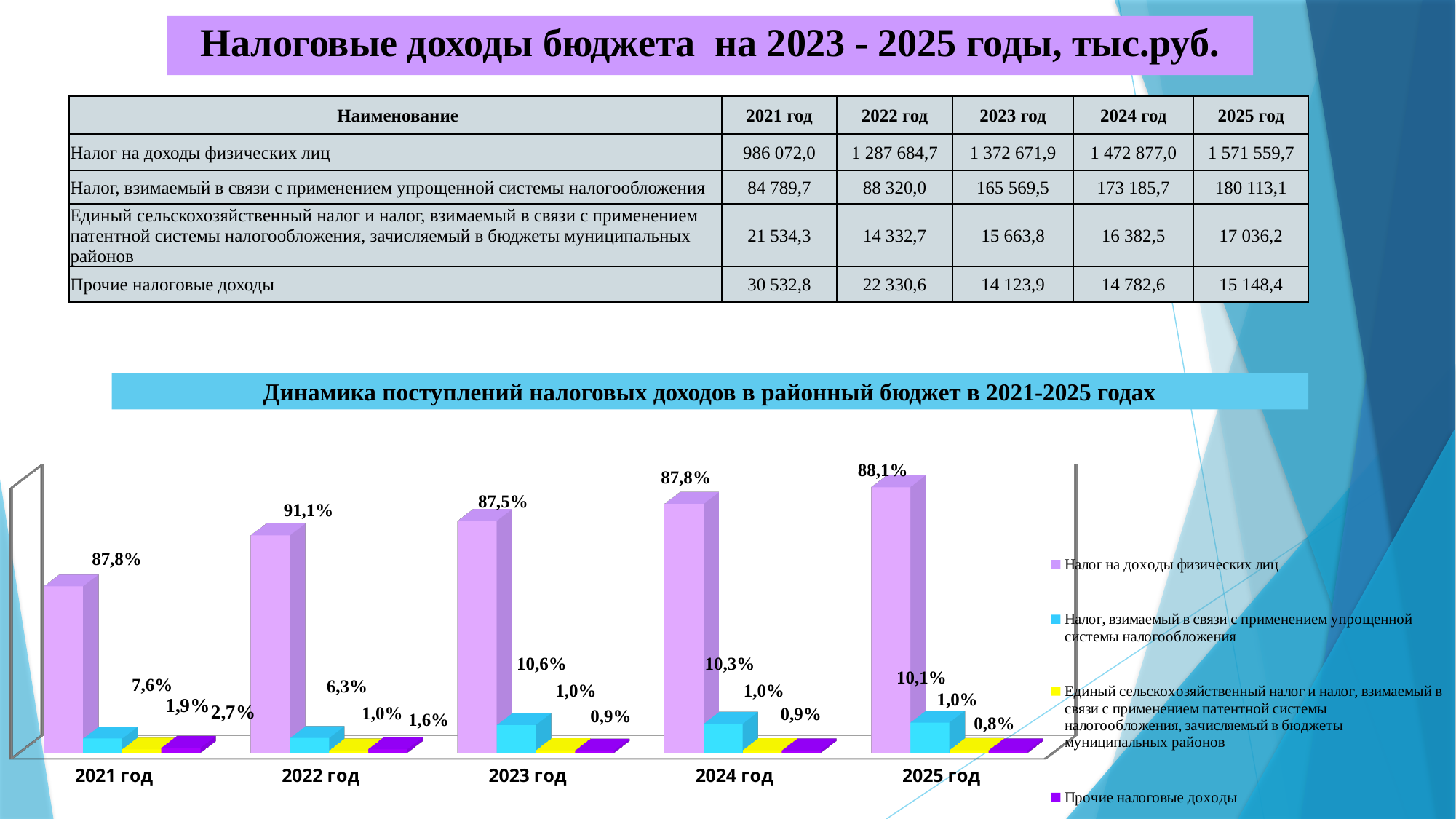
In the chart, what is the value for "Прочие налоговые доходы" in 2021 год? 2,7% How many year categories are shown on the x axis of the chart? 5 In the chart, what is the value for "Налог на доходы физических лиц" in 2022 год? 91,1% In the chart, what is the value for "Налог на доходы физических лиц" in 2025 год? 88,1% What kind of chart is shown under the heading "Динамика поступлений налоговых доходов в районный бюджет в 2021-2025 годах"? bar chart In the chart, which is larger: the "Прочие налоговые доходы" value for 2021 год or for 2025 год? 2021 год In the chart, what is the difference between the "Налог на доходы физических лиц" values for 2022 год and 2023 год? 3,6% In the chart, what is the value for "Налог, взимаемый в связи с применением упрощенной системы налогообложения" in 2023 год? 10,6% In the chart, which series is shown in yellow? Единый сельскохозяйственный налог и налог, взимаемый в связи с применением патентной системы налогообложения, зачисляемый в бюджеты муниципальных районов How many series does the legend of the chart list? 4